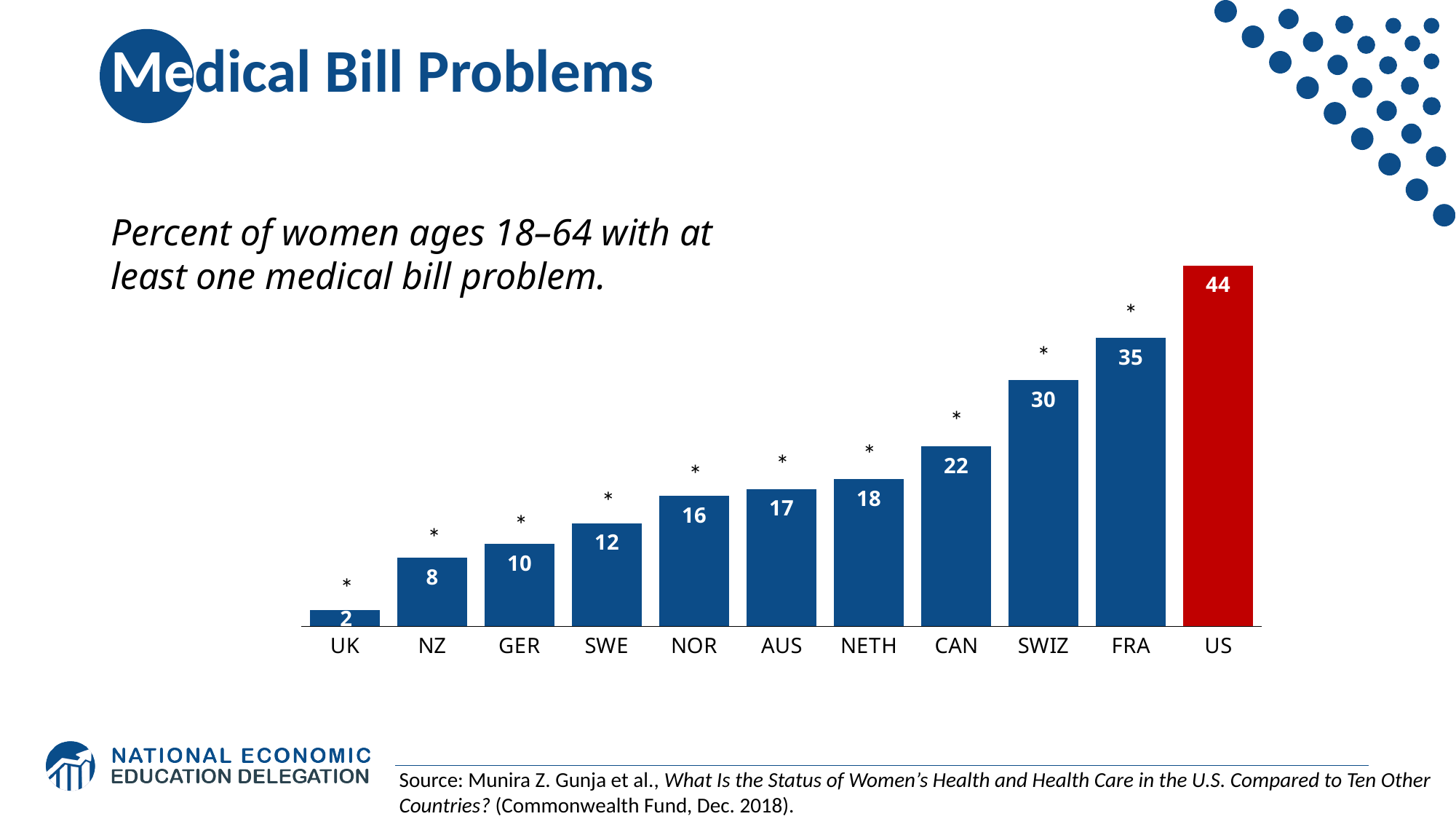
What kind of chart is this? Bar chart Which country has the lowest value? UK How many countries are shown on the chart? 11 Which bar is coloured red rather than blue? US Do the values rise or fall from left to right along the x axis? Rise What is the value for SWE? 12 What is the value for the US? 44 Which has a larger value, NOR or NETH? NETH What is the difference between the values for the US and FRA? 9 Which country has the highest value? US What is the value for CAN? 22 What is the difference between the values for SWIZ and NZ? 22